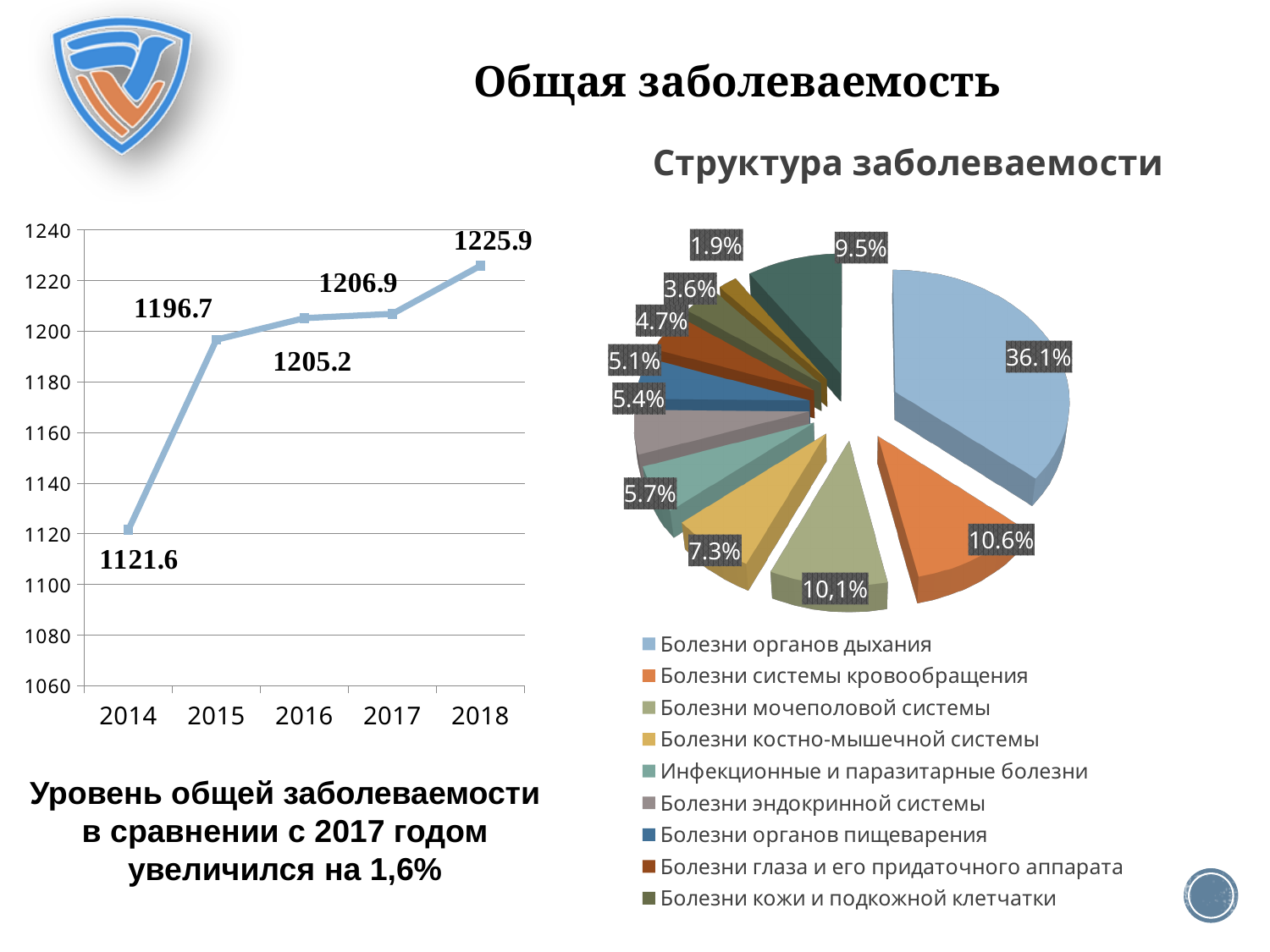
How many entries does the legend of the 'Структура заболеваемости' pie chart list? 9 In the 'Структура заболеваемости' pie chart, what share is 'Болезни органов дыхания'? 36.1% On the line chart on the left, what is the difference between the 2018 and 2017 values? 19.0 On the line chart on the left, do the values rise or fall from 2014 to 2018? rise In the 'Структура заболеваемости' pie chart, what share is 'Болезни системы кровообращения'? 10.6% On the line chart on the left, what is the value for 2014? 1121.6 What kind of chart is the 'Структура заболеваемости' chart? pie chart On the line chart on the left, what is the value for 2016? 1205.2 On the line chart on the left, which year has the lowest value? 2014 On the line chart on the left, what is the value for 2018? 1225.9 On the line chart on the left, how many years are plotted? 5 In the 'Структура заболеваемости' pie chart, which is larger: 'Болезни костно-мышечной системы' or 'Инфекционные и паразитарные болезни'? Болезни костно-мышечной системы